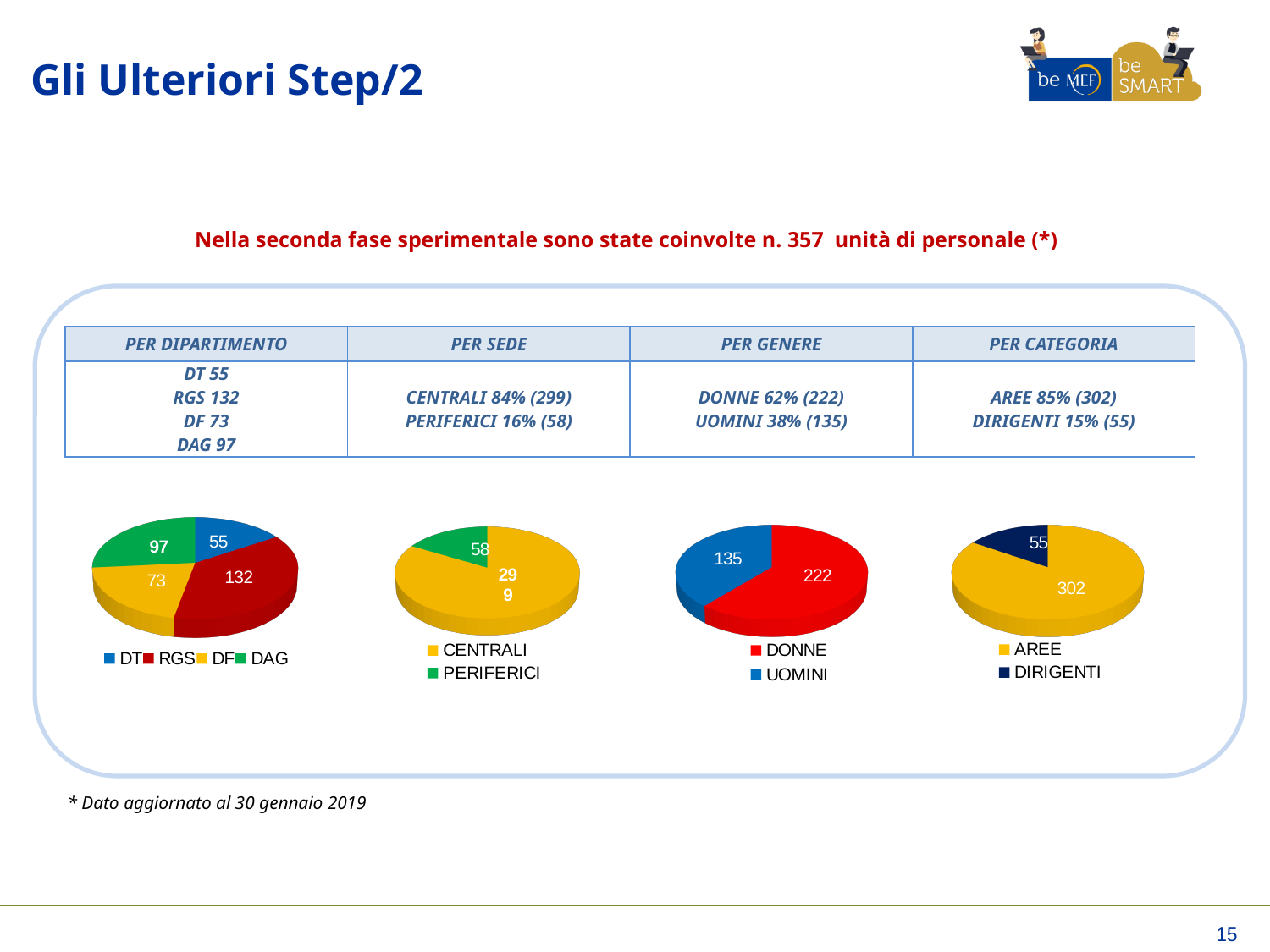
In the leftmost pie chart (PER DIPARTIMENTO), what is the difference between the values for DAG and DF? 24 In the second pie chart from the left (PER SEDE), what is the value for PERIFERICI? 58 In the rightmost pie chart (PER CATEGORIA), what is the value for AREE? 302 In the leftmost pie chart (PER DIPARTIMENTO), which category has the lowest value? DT In the leftmost pie chart (PER DIPARTIMENTO), what is the value for RGS? 132 In the second pie chart from the left (PER SEDE), which category is larger, CENTRALI or PERIFERICI? CENTRALI In the third pie chart from the left (PER GENERE), what is the value for UOMINI? 135 What type of chart is the rightmost chart (PER CATEGORIA)? Pie chart In the third pie chart from the left (PER GENERE), what is the difference between the values for DONNE and UOMINI? 87 In the leftmost pie chart (PER DIPARTIMENTO), which category has the highest value? RGS How many categories does the legend of the leftmost pie chart (PER DIPARTIMENTO) list? 4 In the rightmost pie chart (PER CATEGORIA), what colour is the DIRIGENTI slice? Dark blue